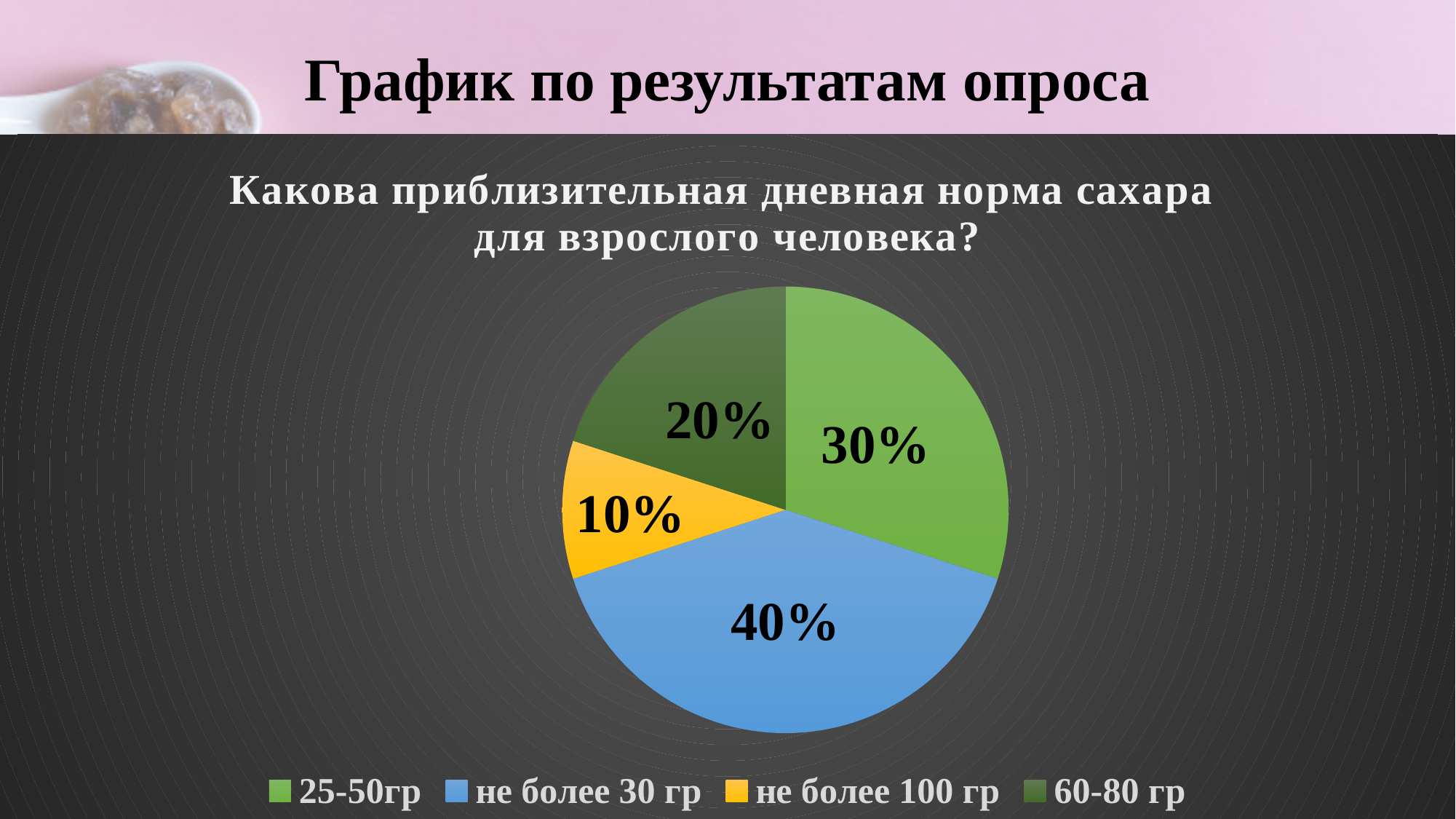
How many slices does the pie chart have? 4 What share of the pie does the "не более 100 гр" slice represent? 10% What is the title of the chart? Какова приблизительная дневная норма сахара для взрослого человека? What share of the pie does the "не более 30 гр" slice represent? 40% Which answer option has the largest share of the pie? не более 30 гр What share of the pie does the "25-50гр" slice represent? 30% What is the difference between the shares for "не более 30 гр" and "25-50гр"? 10% Which answer option has the smallest share of the pie? не более 100 гр What is the difference between the shares for "60-80 гр" and "не более 100 гр"? 10% What kind of chart is shown on the slide? Pie chart Which is larger: the share for "25-50гр" or the share for "60-80 гр"? 25-50гр